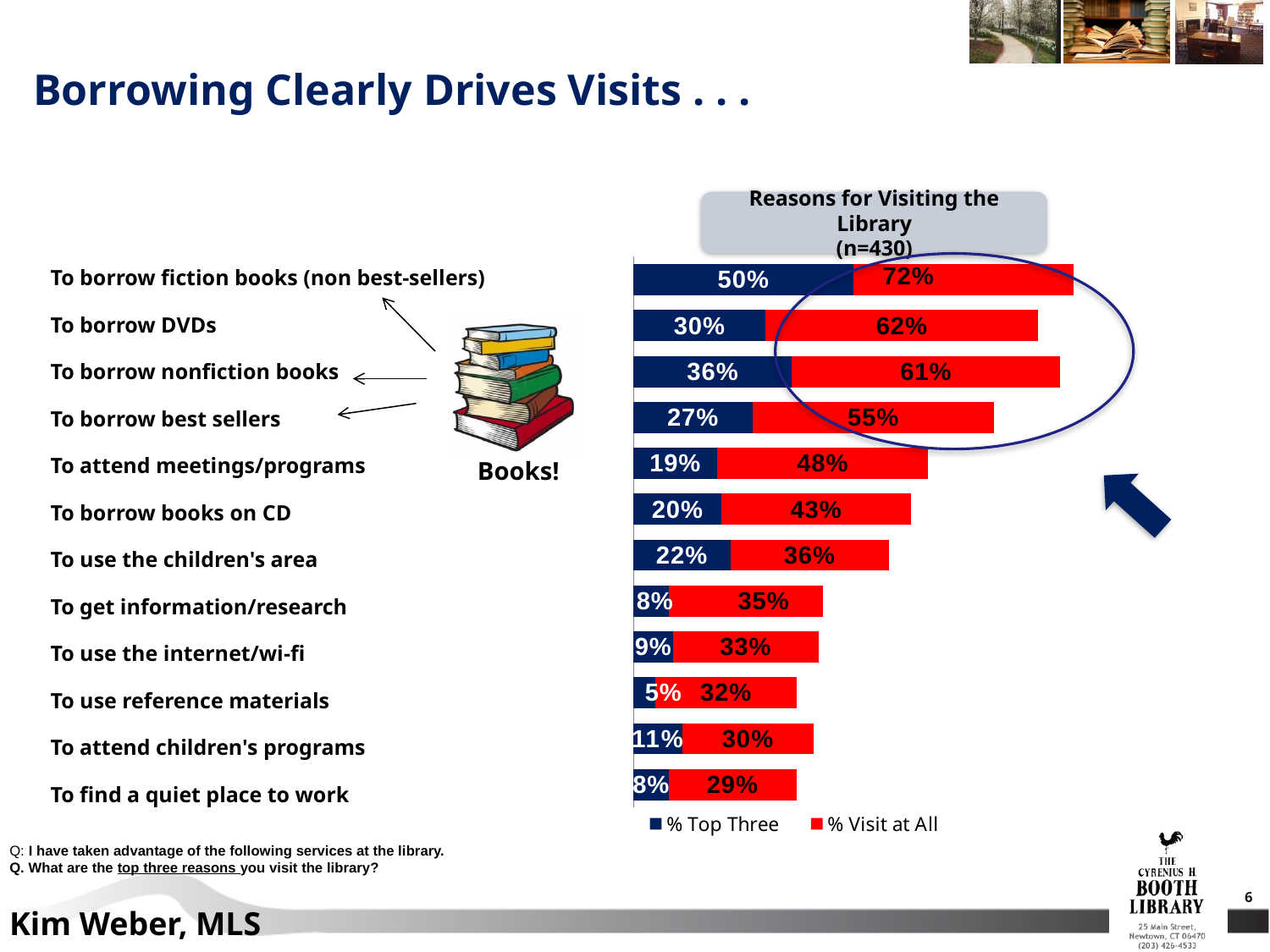
What is the % Visit at All value for 'To use the children's area'? 36% How many reasons for visiting the library are plotted in the chart? 12 What is the difference between the % Visit at All and % Top Three values for 'To borrow DVDs'? 32% Which colour represents the % Visit at All series? red What is the % Top Three value for 'To borrow nonfiction books'? 36% What sample size is shown in the chart title? n=430 Which reason has the highest % Visit at All value? To borrow fiction books (non best-sellers) What kind of chart is shown on the slide? bar chart Which reason has the lowest % Top Three value? To use reference materials Which has a larger % Top Three value: 'To borrow books on CD' or 'To attend meetings/programs'? To borrow books on CD How many series does the legend list? 2 What is the % Visit at All value for 'To borrow fiction books (non best-sellers)'? 72%